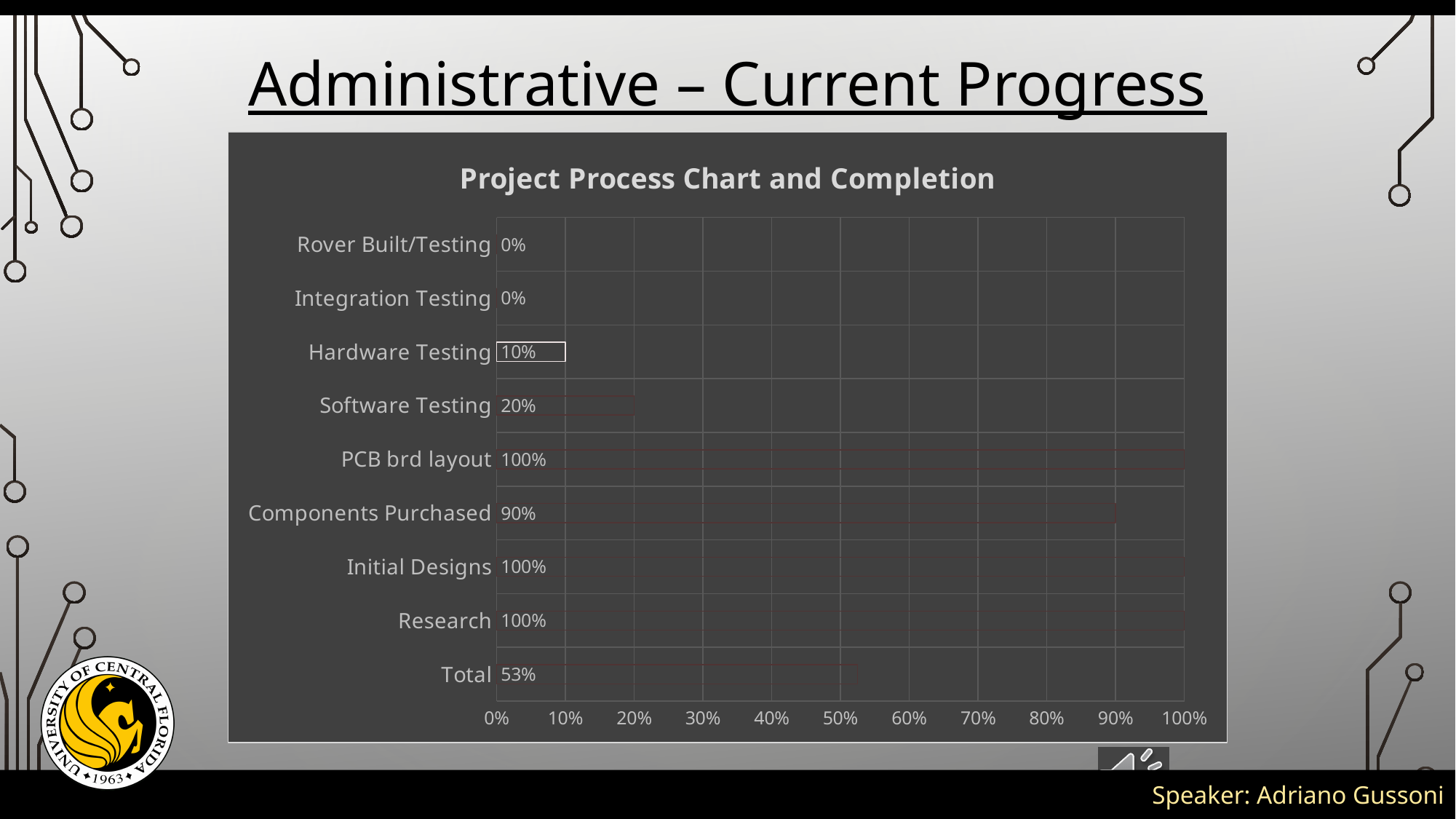
What is the completion value for Software Testing? 20% What is the completion value for Hardware Testing? 10% Is the value for Total greater or less than 50%? greater What is the title of the chart? Project Process Chart and Completion What is the difference between the values for Components Purchased and Software Testing? 70% Which categories have a value of 0%? Rover Built/Testing and Integration Testing How many categories are shown on the chart? 9 What is the highest value shown on the horizontal axis? 100% What is the value shown for Total? 53% What is the completion value for Components Purchased? 90% Which is larger, the value for Hardware Testing or the value for Software Testing? Software Testing What kind of chart is shown on the slide? bar chart